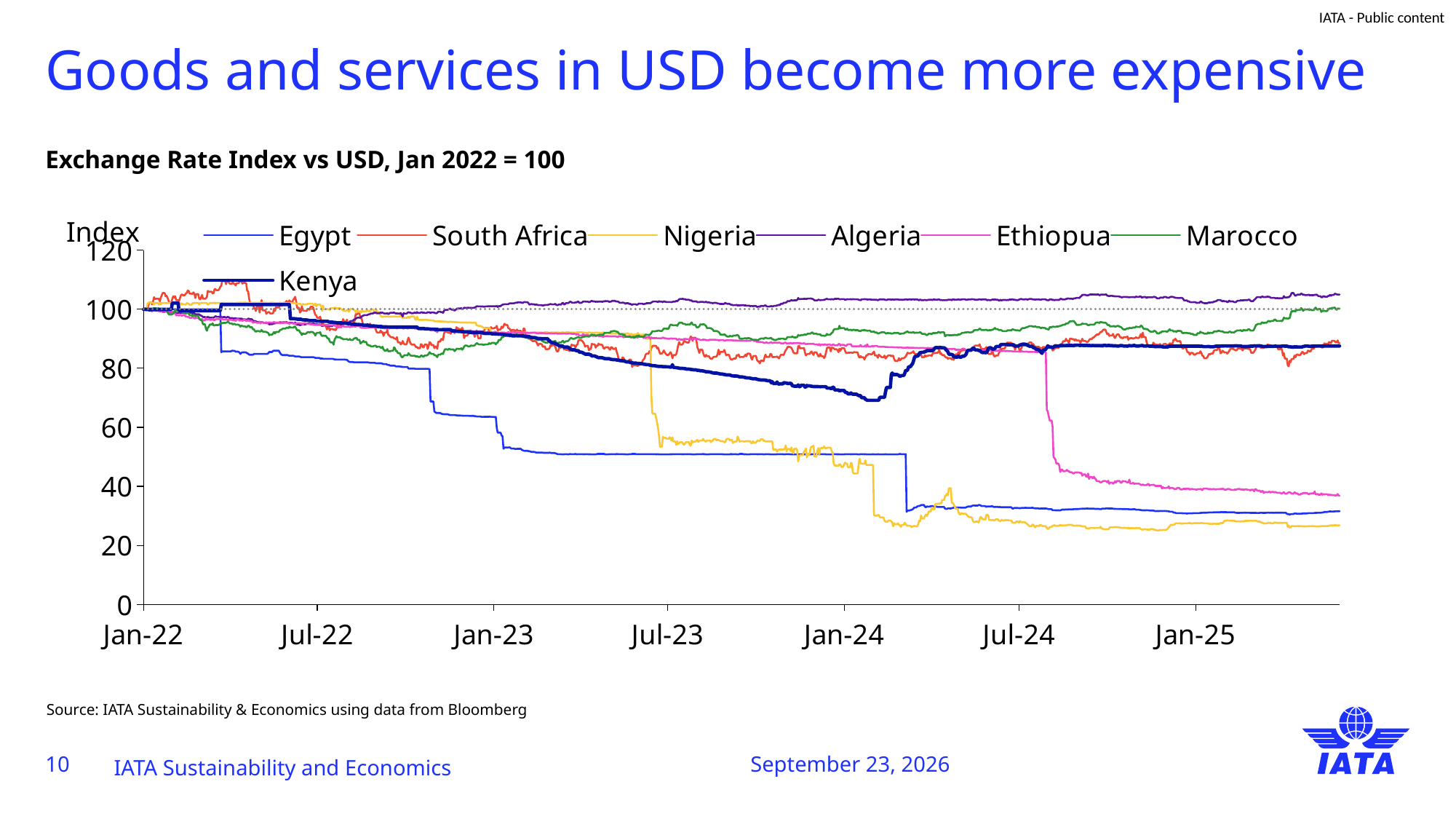
Is the value for Nigeria at the right end of the chart greater or less than 40? less Which series is drawn with a thick dark blue line? Kenya How many series does the legend list? 7 Does the Egypt series rise or fall from Jan-22 to the end of the chart? Fall Which series has the lowest index value at the right end of the chart? Nigeria Is the value for Kenya at the right end of the chart greater or less than 100? less Which series has the highest index value at the right end of the chart? Algeria At Jan-24, which is larger, the value for Kenya or the value for Egypt? Kenya What is the chart's title? Exchange Rate Index vs USD, Jan 2022 = 100 What index value do all series start at in Jan 2022? 100 Is the value for Algeria at the right end of the chart greater or less than 100? greater What kind of chart is shown on the slide? Line chart